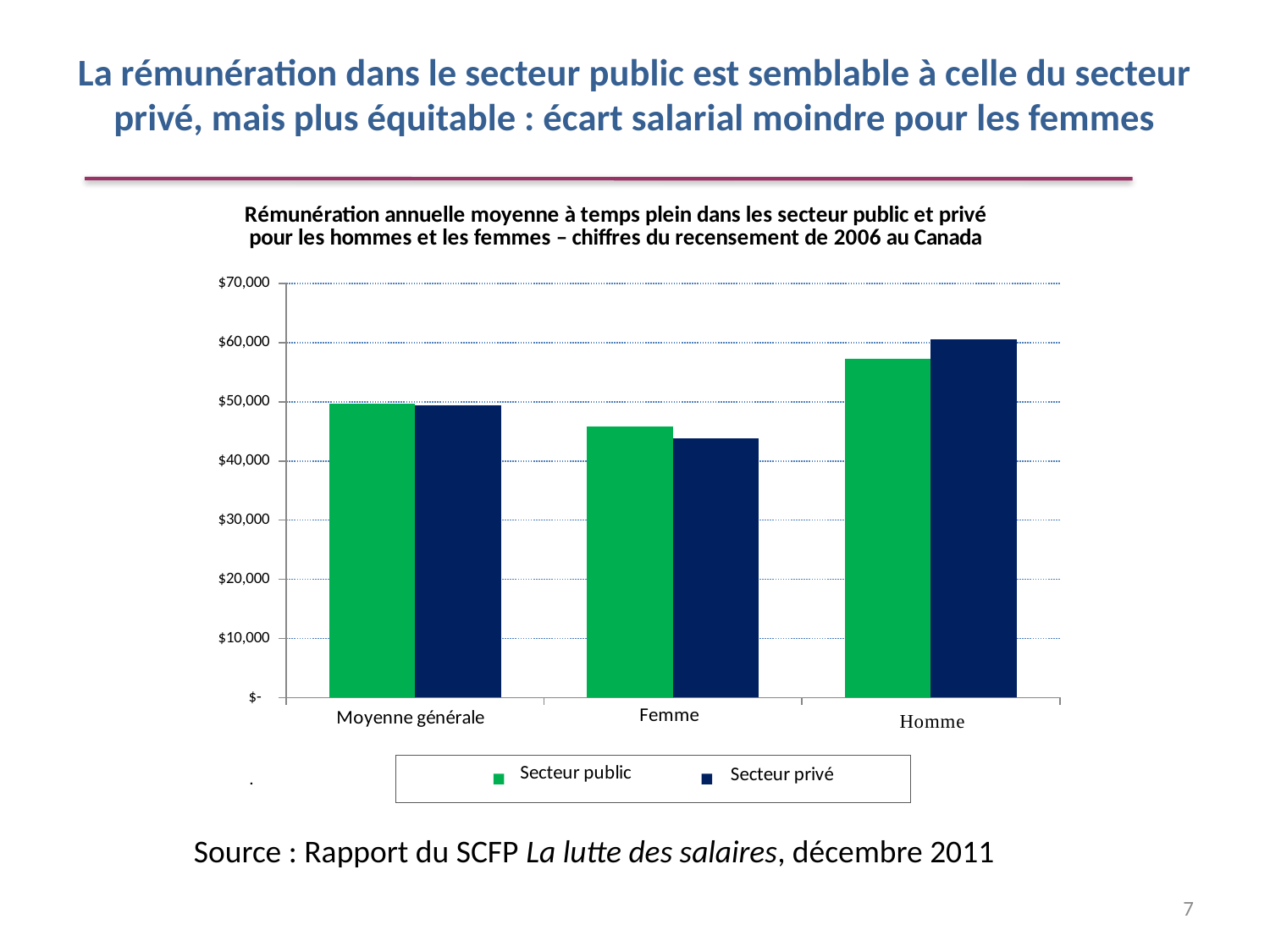
How many categories are shown on the x axis of the chart? 3 Is the value for Homme in Secteur public greater or less than $60,000? less What kind of chart is shown on the slide? bar chart Which series does the green bar represent? Secteur public Which category and series has the highest bar in the chart? Homme, Secteur privé How many series does the legend list? 2 Is the value for Femme in Secteur public greater or less than $40,000? greater Which category and series has the lowest bar in the chart? Femme, Secteur privé Is the value for Femme in Secteur privé greater or less than $50,000? less For Femme, which is larger: Secteur public or Secteur privé? Secteur public For Homme, which is larger: Secteur public or Secteur privé? Secteur privé